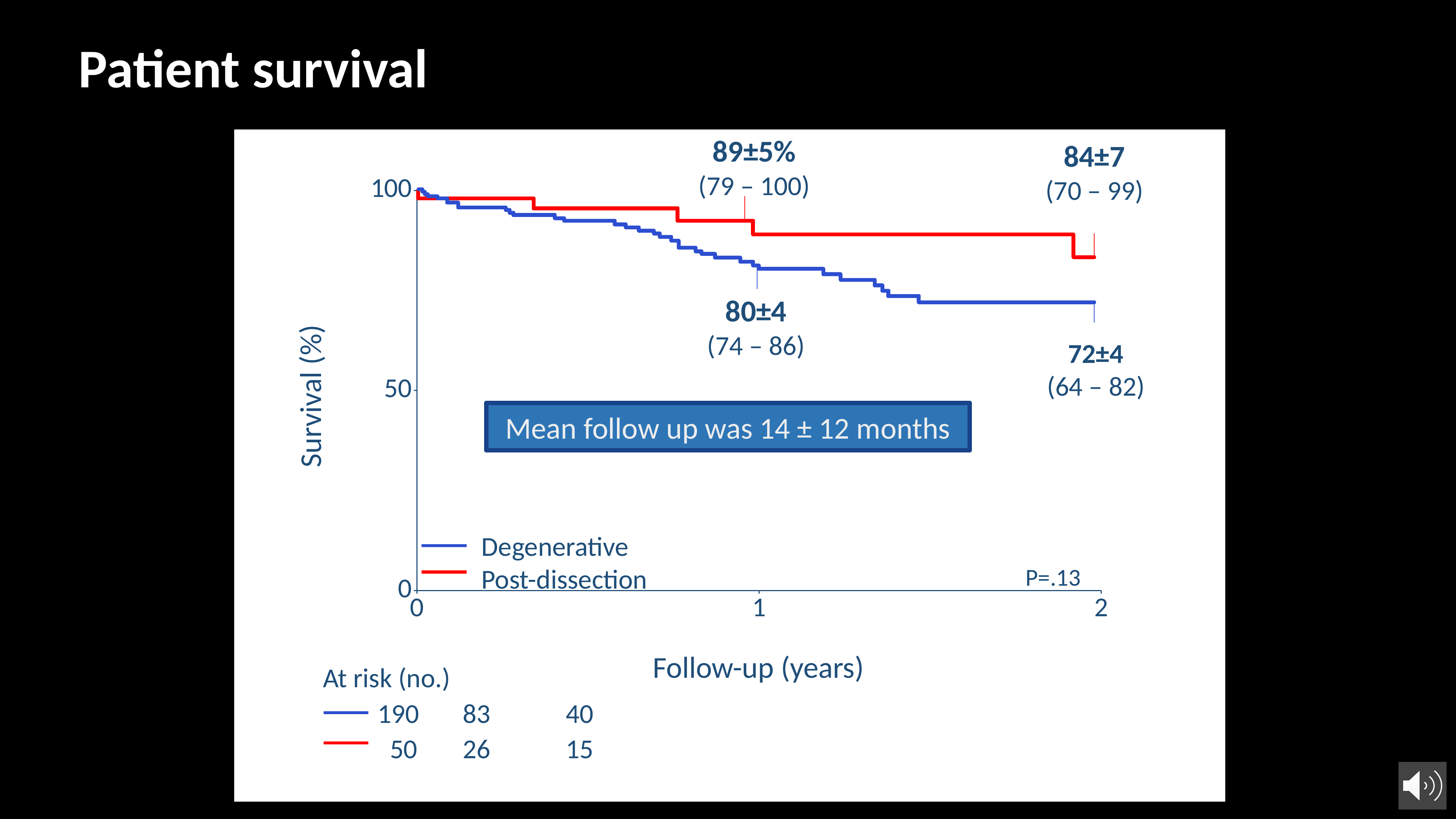
What is the survival estimate for the Degenerative group at 1 year of follow-up? 80±4 Do the survival curves rise or fall as follow-up time increases? Fall What is the survival estimate for the Post-dissection group at 1 year of follow-up? 89±5% How many series does the legend list? 2 What is the difference between the number of Degenerative and Post-dissection patients at risk at 1 year? 57 What is the confidence interval shown for the Degenerative group at 2 years? (64 – 82) What is the survival estimate for the Post-dissection group at 2 years of follow-up? 84±7 What is the survival estimate for the Degenerative group at 2 years of follow-up? 72±4 How many Degenerative patients were at risk at the start of follow-up (time 0)? 190 How many Post-dissection patients were at risk at 2 years? 15 Which group has the higher survival at 2 years, Degenerative or Post-dissection? Post-dissection What P value is shown on the chart? P=.13